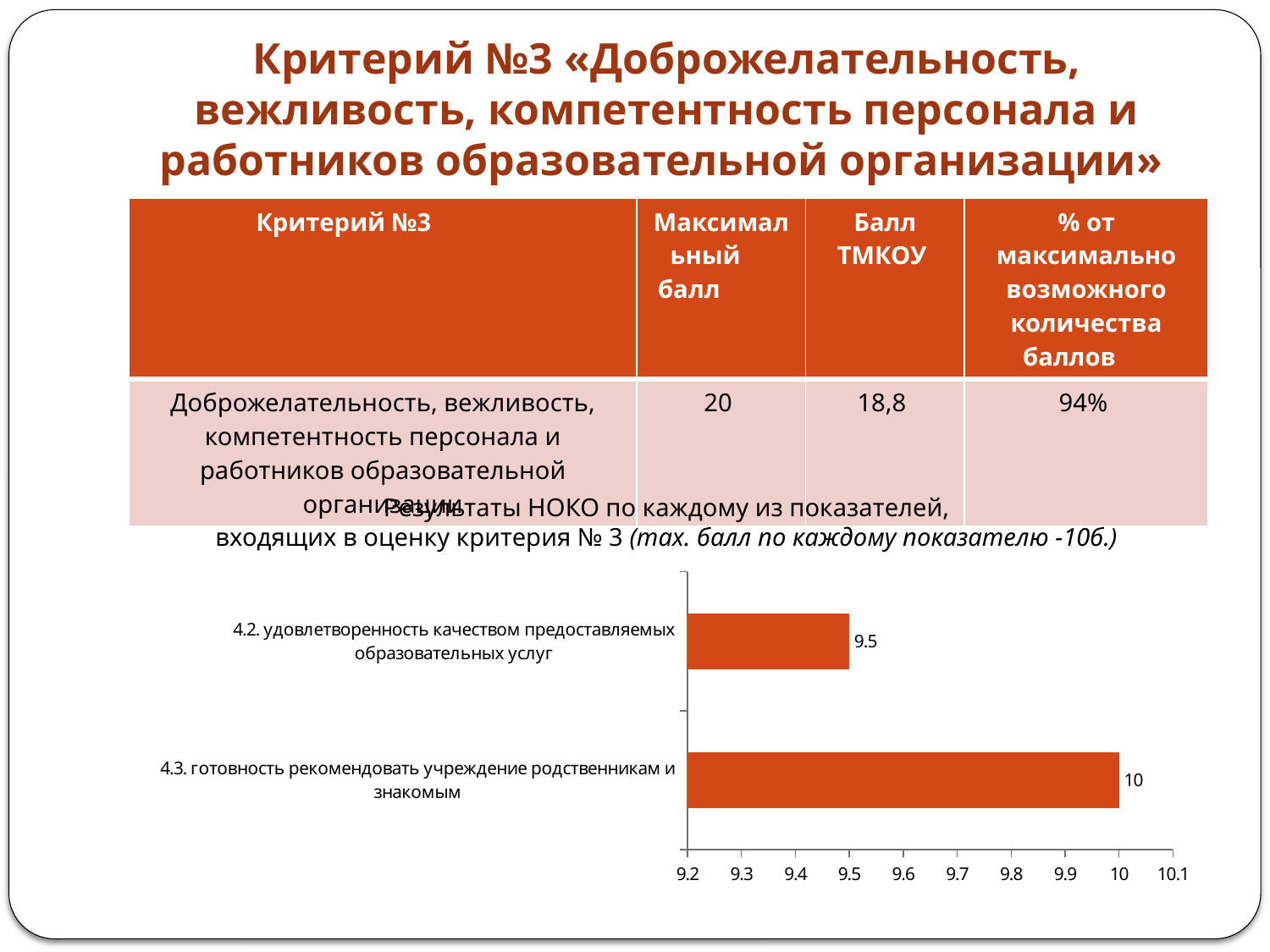
Is the value for indicator 4.3 greater or less than 9.8? greater How many indicators (bars) are shown in the chart? 2 What is the maximum value shown on the chart's value axis? 10.1 What kind of chart is shown on the slide? bar chart What is the value for indicator 4.2 (удовлетворенность качеством предоставляемых образовательных услуг)? 9.5 What is the difference between the values for indicator 4.3 and indicator 4.2? 0.5 Is the value for indicator 4.2 greater or less than 9.7? less Which indicator has the highest value in the chart? 4.3. готовность рекомендовать учреждение родственникам и знакомым Which is larger: the value for indicator 4.2 or indicator 4.3? 4.3 What colour are the bars in the chart? orange-red Which indicator has the lowest value in the chart? 4.2. удовлетворенность качеством предоставляемых образовательных услуг What is the value for indicator 4.3 (готовность рекомендовать учреждение родственникам и знакомым)? 10